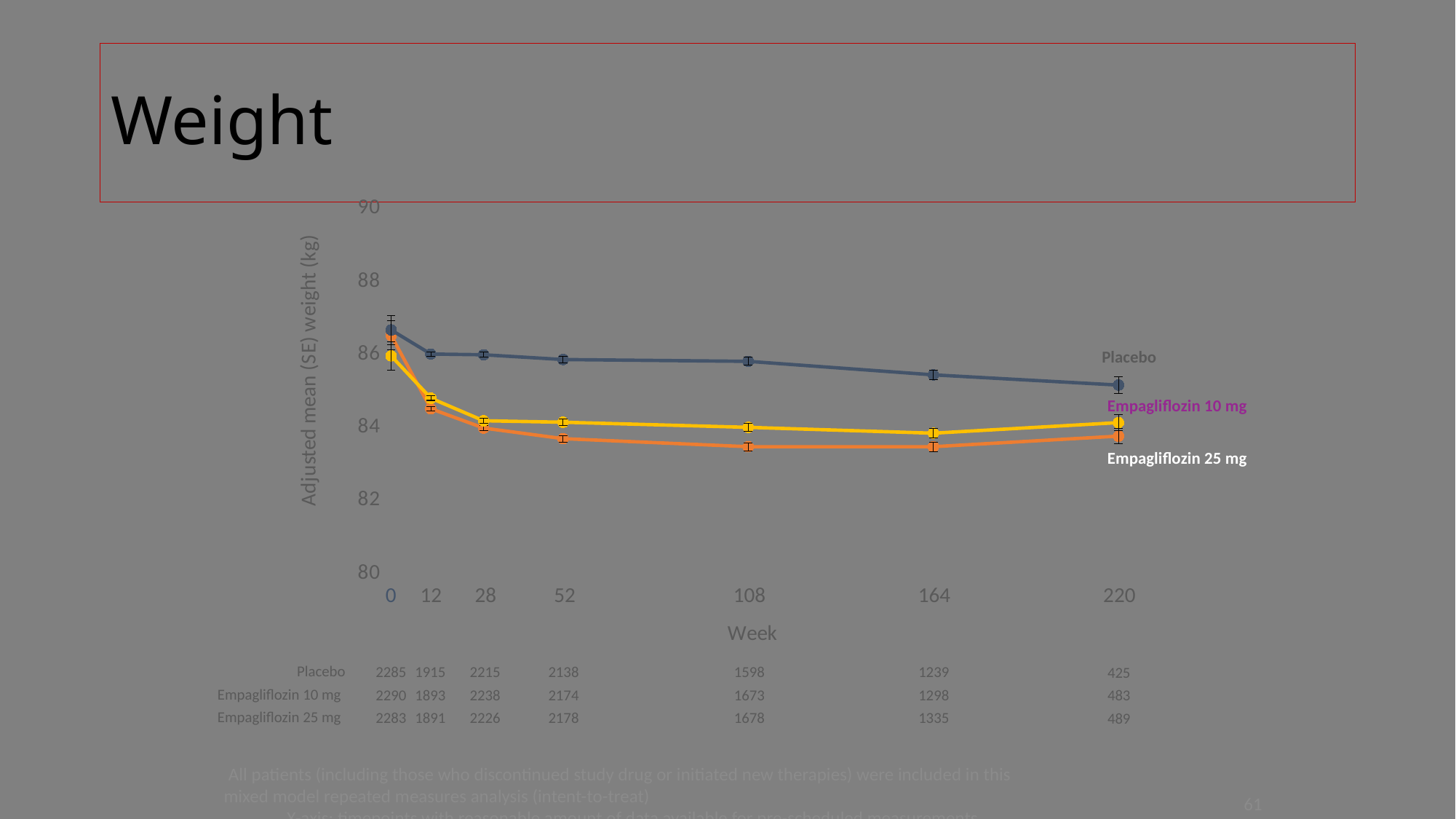
How many series are plotted on the chart? 3 Which series has the highest value at week 0? Placebo Is the value for Placebo at week 0 greater or less than 86? greater At week 220, which is higher: Placebo or Empagliflozin 25 mg? Placebo Is the value for Placebo at week 164 greater or less than 86? less What kind of chart is shown on the slide? Line chart Does the Placebo line rise or fall from week 0 to week 220? Fall Which series has the lowest value at week 108? Empagliflozin 25 mg Is the value for Placebo at week 220 greater or less than 84? greater How many week time points are shown on the x axis? 7 What is the label of the y axis? Adjusted mean (SE) weight (kg)